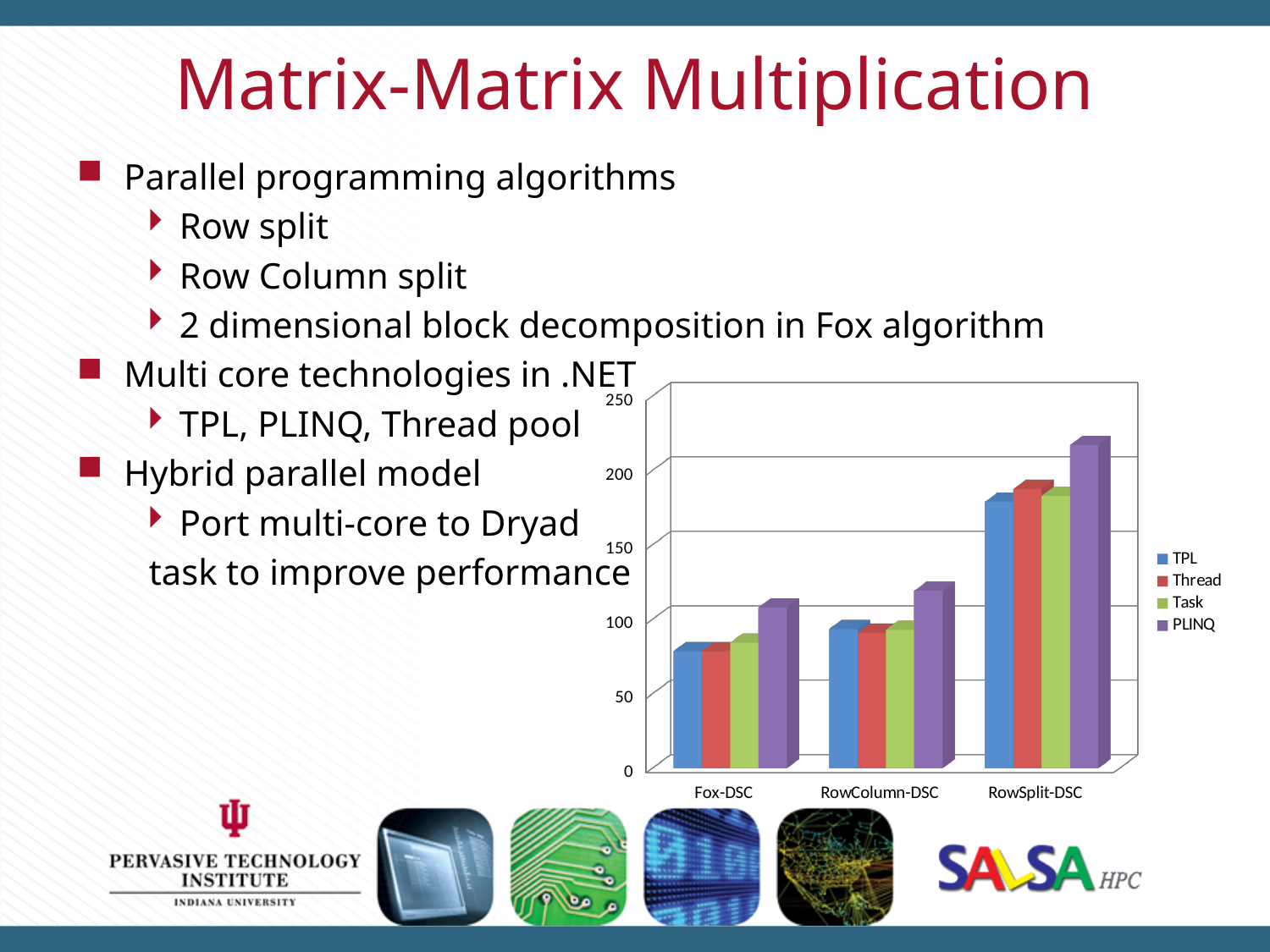
How many series does the chart's legend list? 4 Is the PLINQ value for RowSplit-DSC greater or less than 200? greater Which category has the highest PLINQ value? RowSplit-DSC Do the PLINQ values rise or fall moving from Fox-DSC to RowSplit-DSC along the x axis? rise Which series is shown in purple in the chart's legend? PLINQ What kind of chart is shown on the slide? bar chart How many categories are shown on the x axis of the chart? 3 Is the PLINQ value for RowColumn-DSC greater or less than 100? greater Is the TPL value for Fox-DSC greater or less than 100? less For Fox-DSC, which is larger: the PLINQ value or the TPL value? PLINQ Which category has the lowest TPL value? Fox-DSC